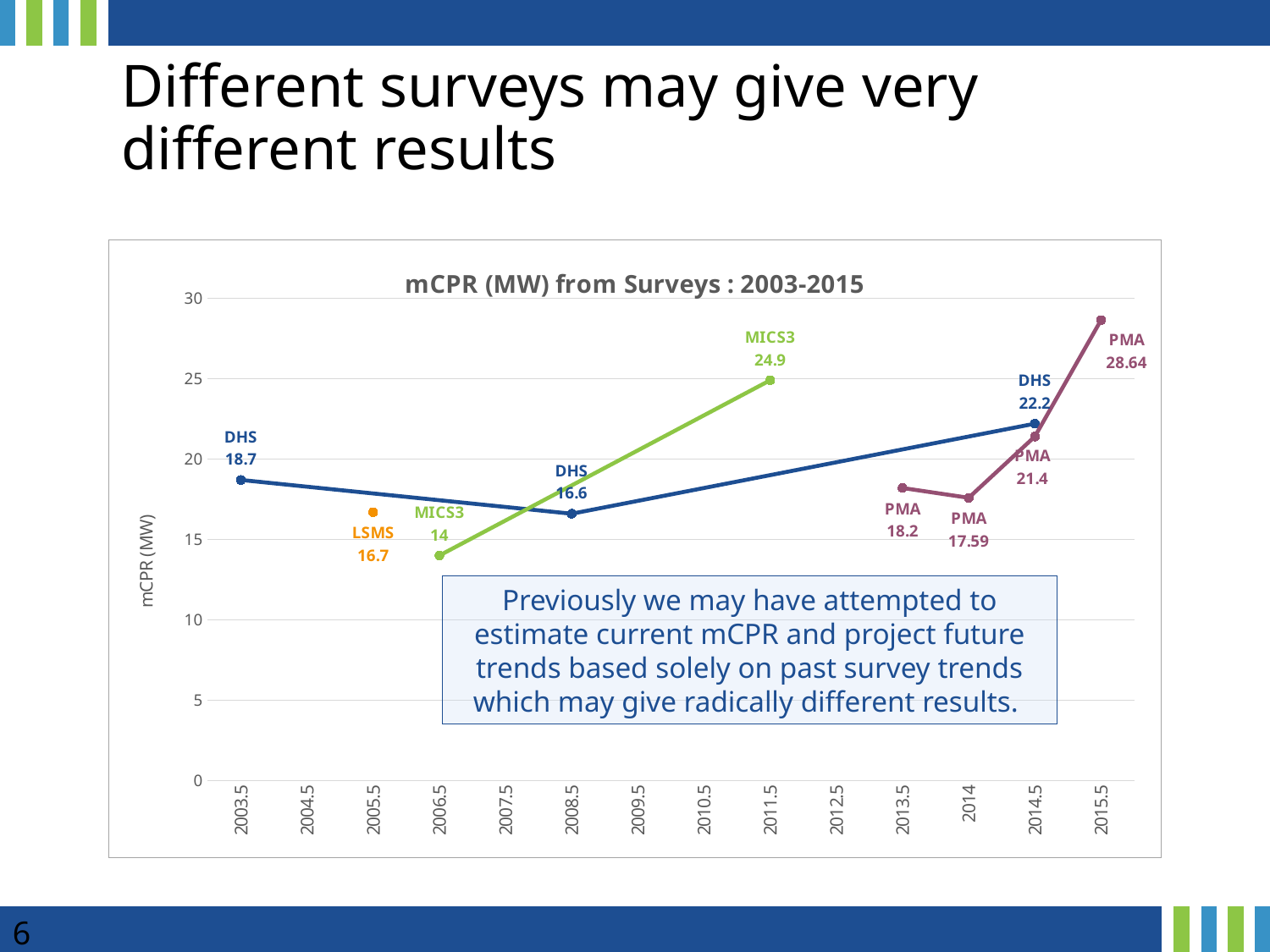
Which is larger at 2014.5, the DHS value or the PMA value? DHS (22.2) What type of chart is shown on the slide? line chart What is the DHS value at 2003.5? 18.7 Which labelled survey point has the highest mCPR value? PMA 28.64 What is the MICS3 value at 2011.5? 24.9 What is the PMA value at 2015.5? 28.64 What is the difference between the two MICS3 values (24.9 and 14)? 10.9 Which labelled survey point has the lowest mCPR value? MICS3 14 What is the LSMS value shown on the chart? 16.7 What is the title of the chart? mCPR (MW) from Surveys : 2003-2015 Do the DHS values rise or fall between 2008.5 and 2014.5? rise What is the label of the y axis? mCPR (MW)